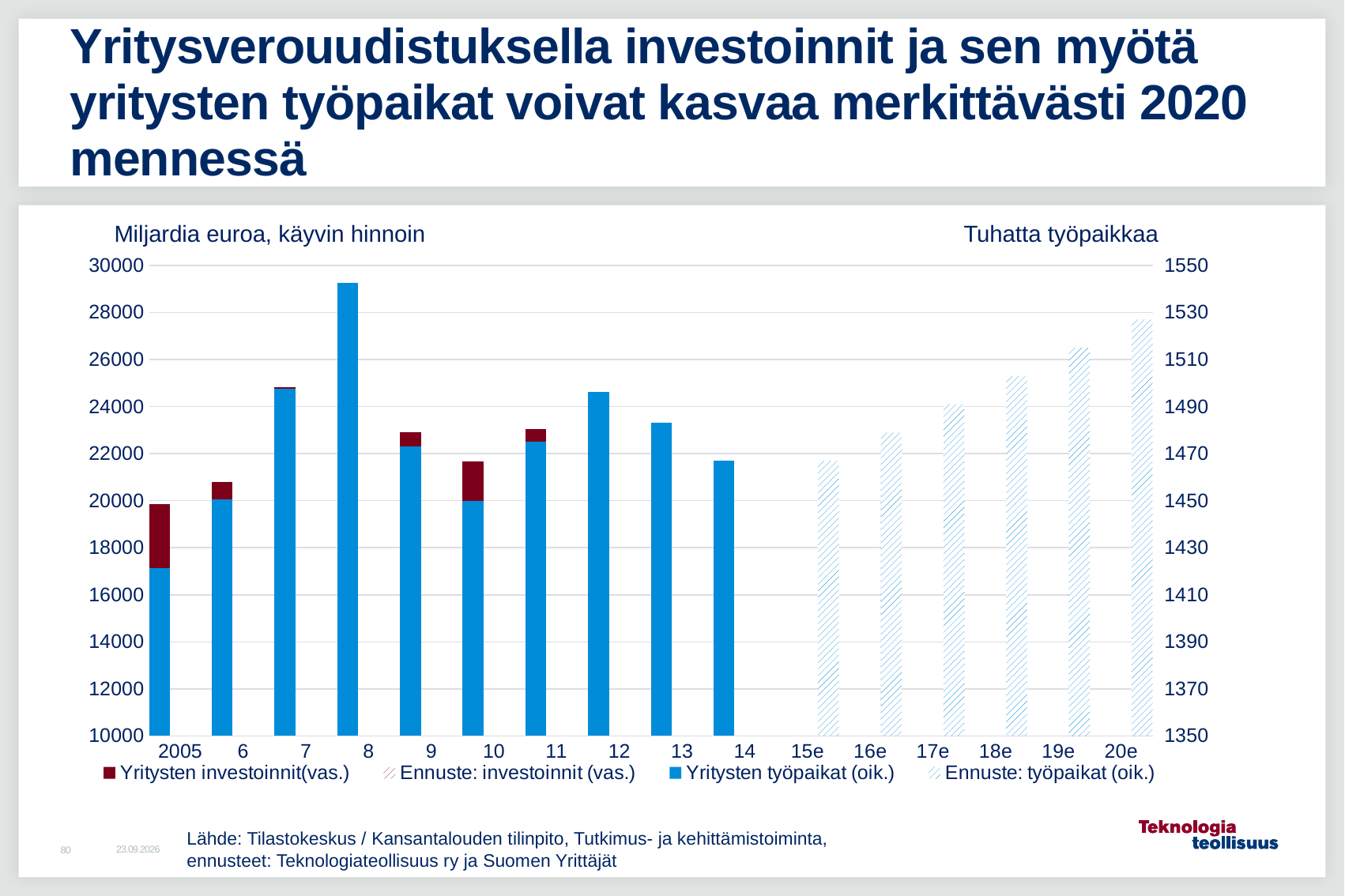
What kind of chart is shown on the slide? bar chart Is the 'Ennuste: työpaikat (oik.)' value for 17e greater or less than 1470 on the right axis? greater Is the 'Yritysten työpaikat (oik.)' value for 8 greater or less than 1530 on the right axis? greater Do the 'Ennuste: työpaikat (oik.)' bars rise or fall from 15e to 20e? rise Is the 'Yritysten työpaikat (oik.)' value for 2005 greater or less than 1430 on the right axis? less In which year is the blue 'Yritysten työpaikat (oik.)' bar the highest? 8 How many series does the legend list? 4 What is the title of the right-hand axis? Tuhatta työpaikkaa In which year is the blue 'Yritysten työpaikat (oik.)' bar the lowest? 2005 Which has the higher 'Yritysten työpaikat (oik.)' bar, 12 or 13? 12 How many categories are shown along the x axis? 16